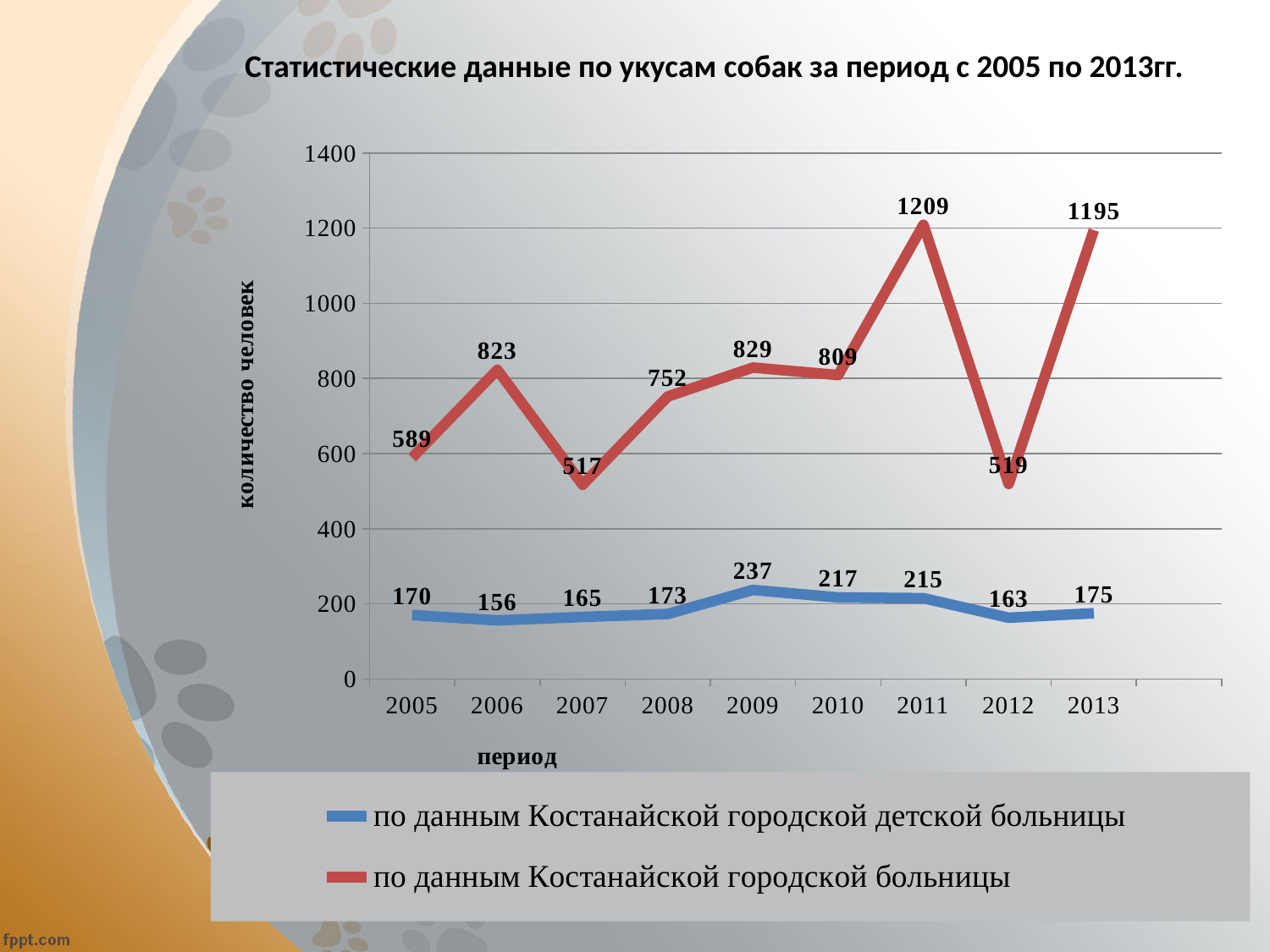
How many years are shown on the x axis? 9 In which year is the value for 'по данным Костанайской городской детской больницы' the highest? 2009 What is the difference between the 2013 and 2012 values for 'по данным Костанайской городской больницы'? 676 What value does the series 'по данным Костанайской городской детской больницы' show for 2009? 237 How many series does the legend list? 2 In which year is the value for 'по данным Костанайской городской больницы' the lowest? 2007 Is the 2008 value for 'по данным Костанайской городской больницы' greater or less than 800? less Does the value for 'по данным Костанайской городской детской больницы' rise or fall from 2005 to 2006? fall Which is larger for 'по данным Костанайской городской детской больницы': the value for 2010 or the value for 2011? 2010 What kind of chart is shown on the slide? line chart What is the label of the y axis? количество человек What value does the series 'по данным Костанайской городской больницы' show for 2011? 1209